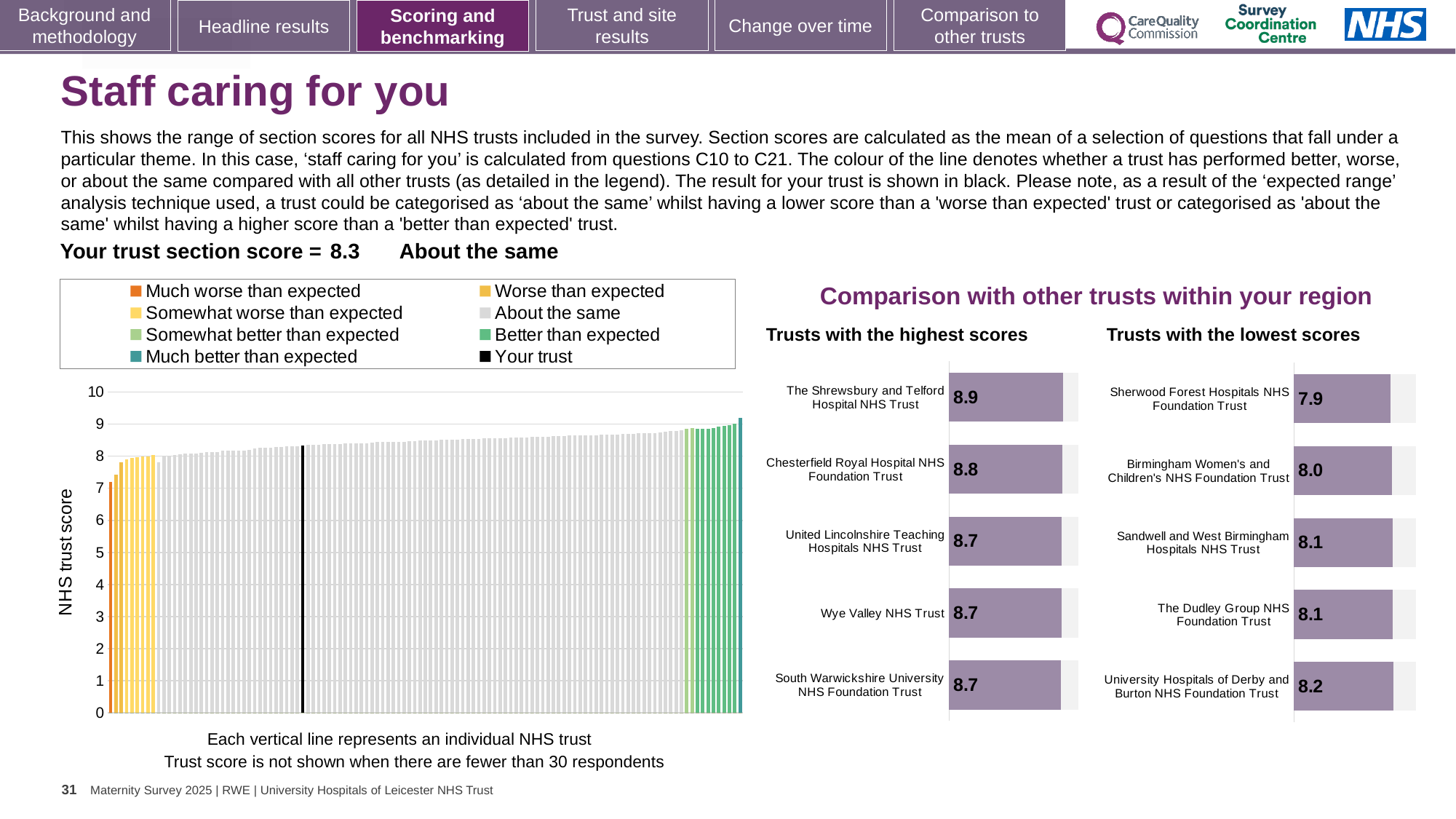
How many trusts are shown in the 'Trusts with the highest scores' chart? 5 In the NHS trust score chart on the left, do the values rise or fall from left to right along the x axis? Rise In the NHS trust score chart on the left, what colour represents 'Your trust' according to the legend? Black What is the difference between the score for The Shrewsbury and Telford Hospital NHS Trust in the highest scores chart and the score for Sherwood Forest Hospitals NHS Foundation Trust in the lowest scores chart? 1.0 What kind of chart is the 'Trusts with the lowest scores' chart? Bar chart In the NHS trust score chart on the left, is the value of the black bar (your trust) greater or less than 5? greater How many legend entries does the NHS trust score chart on the left list? 8 In the 'Trusts with the highest scores' chart, which trust has the highest score? The Shrewsbury and Telford Hospital NHS Trust In the 'Trusts with the highest scores' chart, what is the score for The Shrewsbury and Telford Hospital NHS Trust? 8.9 In the 'Trusts with the lowest scores' chart, which has the larger score: Birmingham Women's and Children's NHS Foundation Trust or University Hospitals of Derby and Burton NHS Foundation Trust? University Hospitals of Derby and Burton NHS Foundation Trust In the 'Trusts with the lowest scores' chart, what is the score for Sherwood Forest Hospitals NHS Foundation Trust? 7.9 In the 'Trusts with the lowest scores' chart, which trust has the lowest score? Sherwood Forest Hospitals NHS Foundation Trust